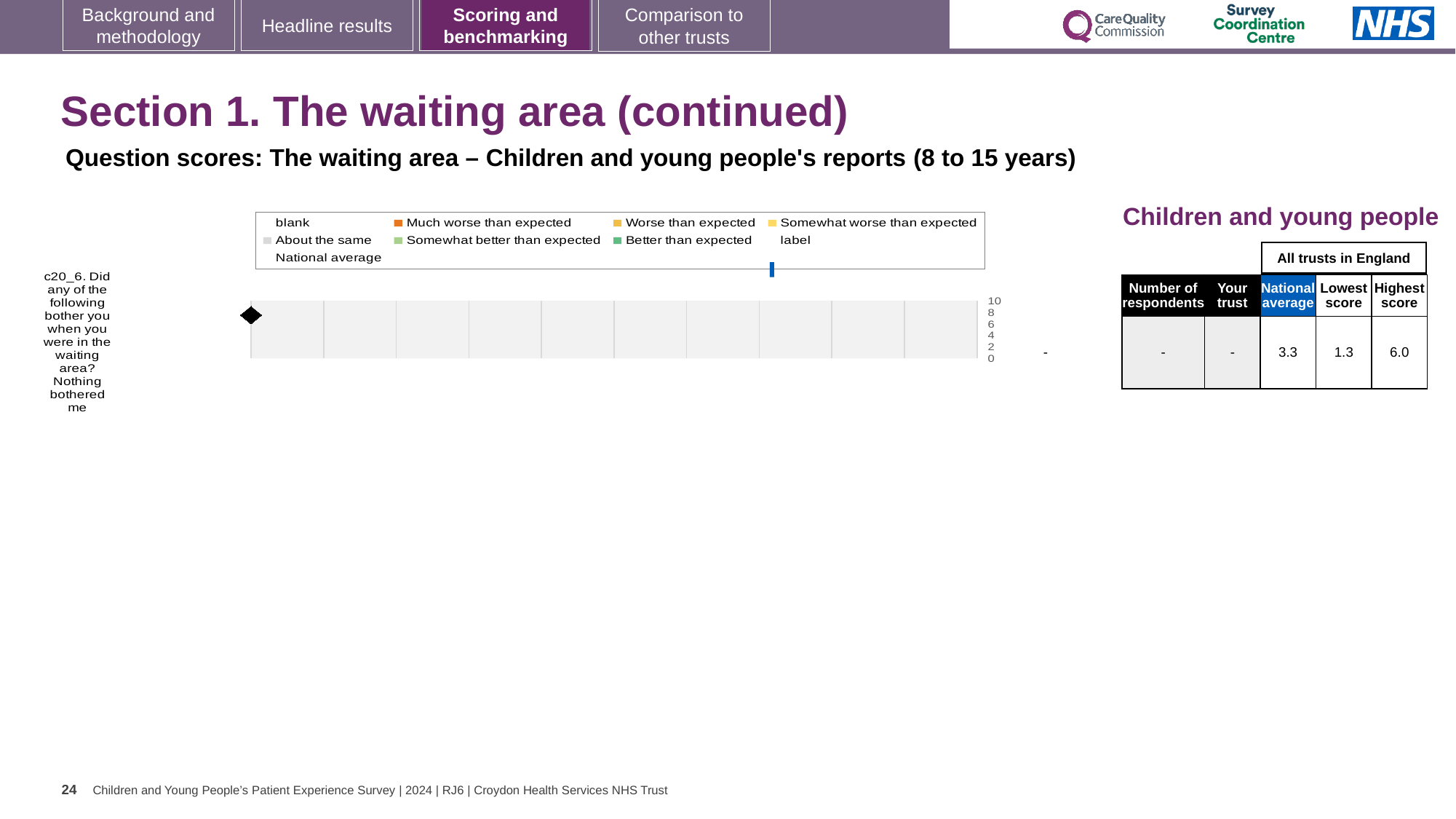
In the table next to the chart, what is the national average score for question c20_6? 3.3 Which legend entry is shown in orange? Much worse than expected What is the highest value shown on the chart's axis? 10 How many question categories are plotted on the chart? 1 In the table next to the chart, what is the difference between the highest score and the lowest score for question c20_6? 4.7 In the table next to the chart, what is the lowest score across all trusts in England for question c20_6? 1.3 How many entries does the chart legend list? 9 What value is shown for 'Your trust' for question c20_6 on the chart? - In the table next to the chart, what is the highest score across all trusts in England for question c20_6? 6.0 In the table next to the chart, is the national average score for question c20_6 greater or less than 5? less What kind of chart is shown on the slide? bar chart